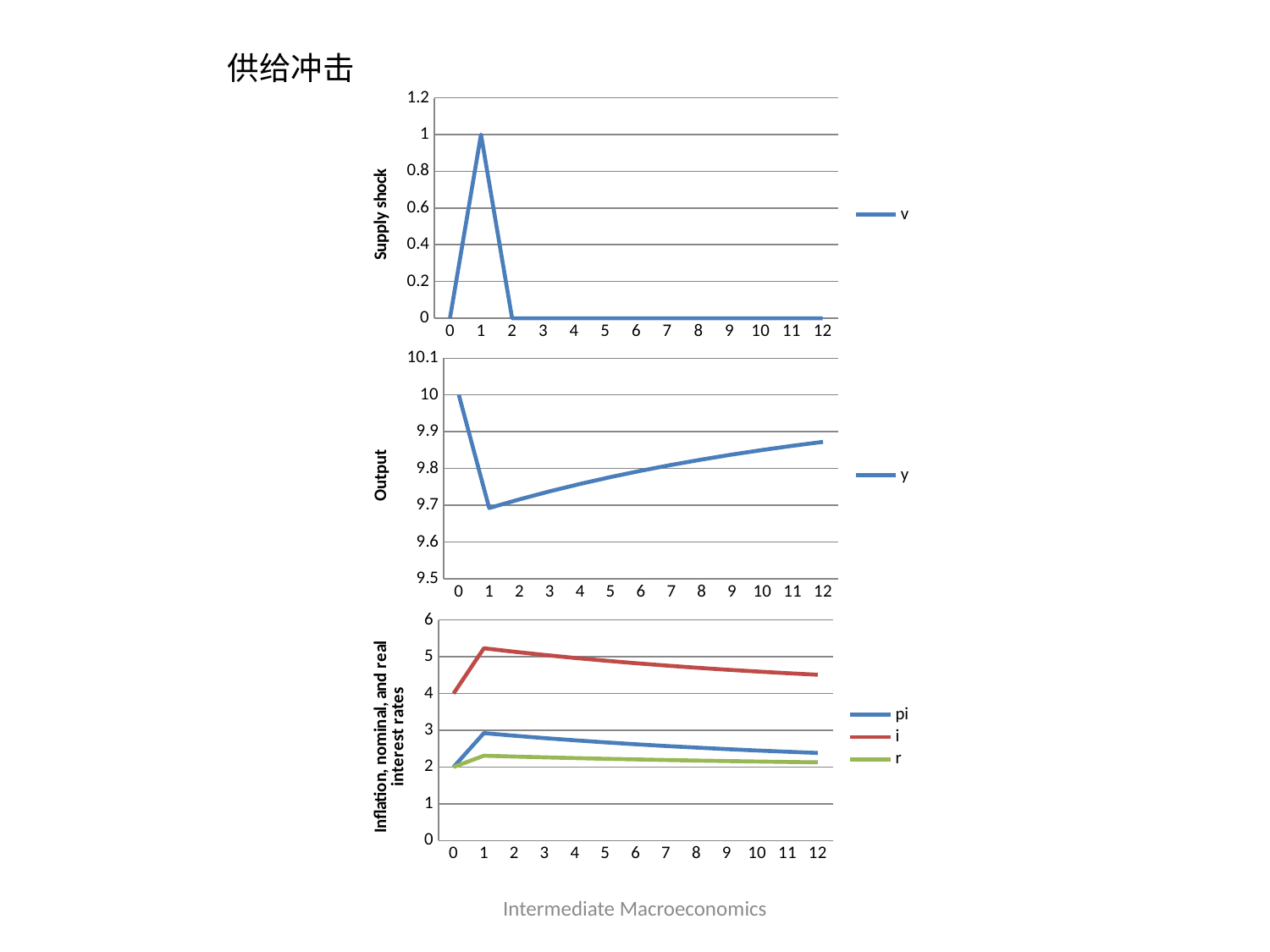
In the middle chart (Output), does y rise or fall from period 1 to period 12? rise In the bottom chart, is the value of pi at period 1 greater or less than 2? greater What type of chart is the top chart labelled Supply shock? line chart In the bottom chart, what is the value of i at period 0? 4 In the bottom chart, which series is larger at period 6, i or r? i In the middle chart (Output), is the value of y at period 12 greater or less than 9.8? greater In the middle chart (Output), at which period is y lowest? 1 In the top chart (Supply shock), at which period is v highest? 1 In the top chart (Supply shock), what is the value of v at period 5? 0 In the bottom chart, how many series does the legend list? 3 In the top chart (Supply shock), what is the value of v at period 1? 1 In the middle chart (Output), what is the value of y at period 0? 10